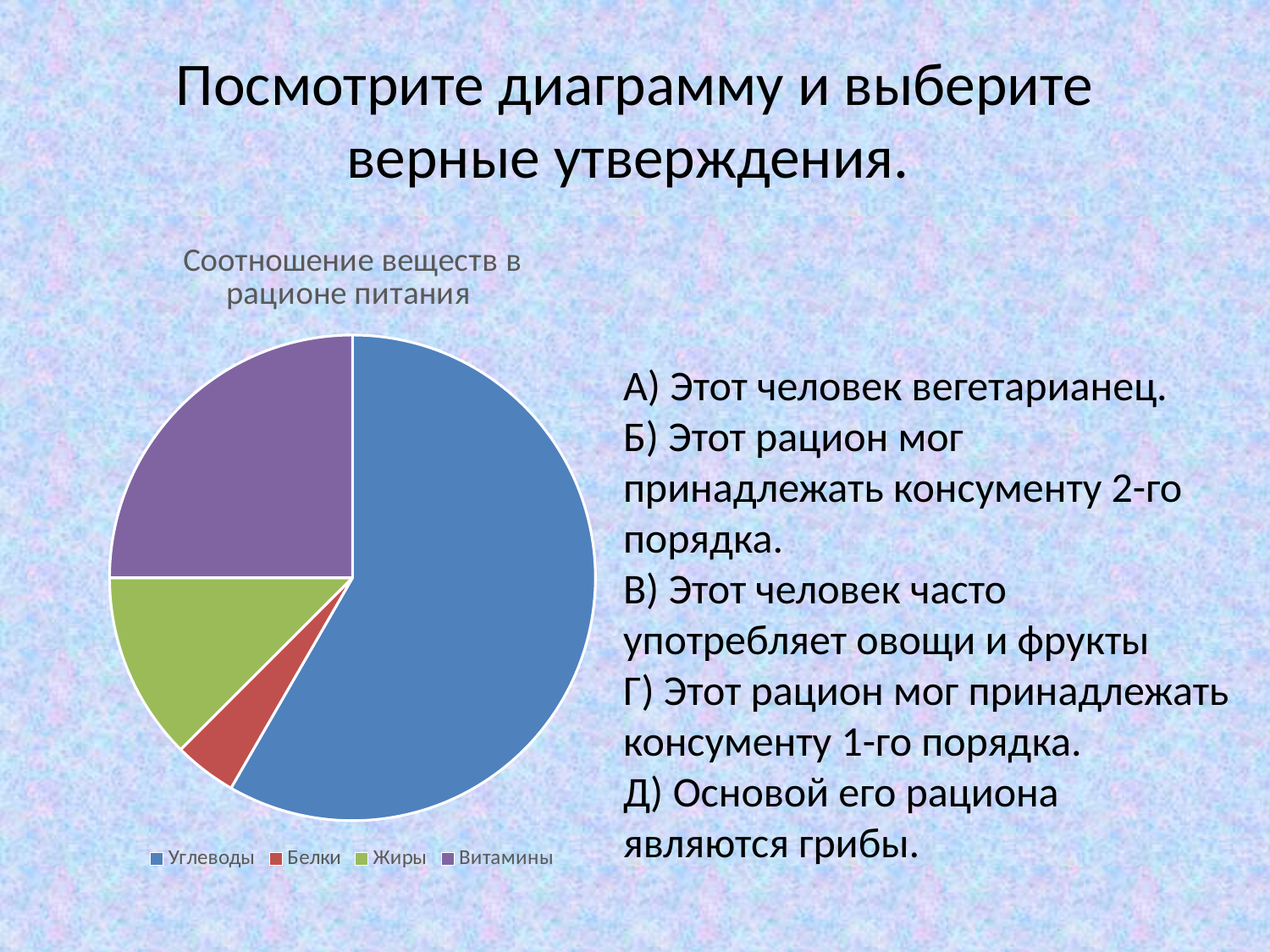
Which category is shown in purple in the pie chart? Витамины What kind of chart is shown on the slide? pie chart How many entries does the legend list? 4 Which category has the largest slice of the pie? Углеводы How many slices does the pie chart have? 4 Which slice is larger, Витамины or Жиры? Витамины Which category has the smallest slice of the pie? Белки Which slice is larger, Углеводы or Витамины? Углеводы Which slice is larger, Белки or Жиры? Жиры What is the title of the chart? Соотношение веществ в рационе питания